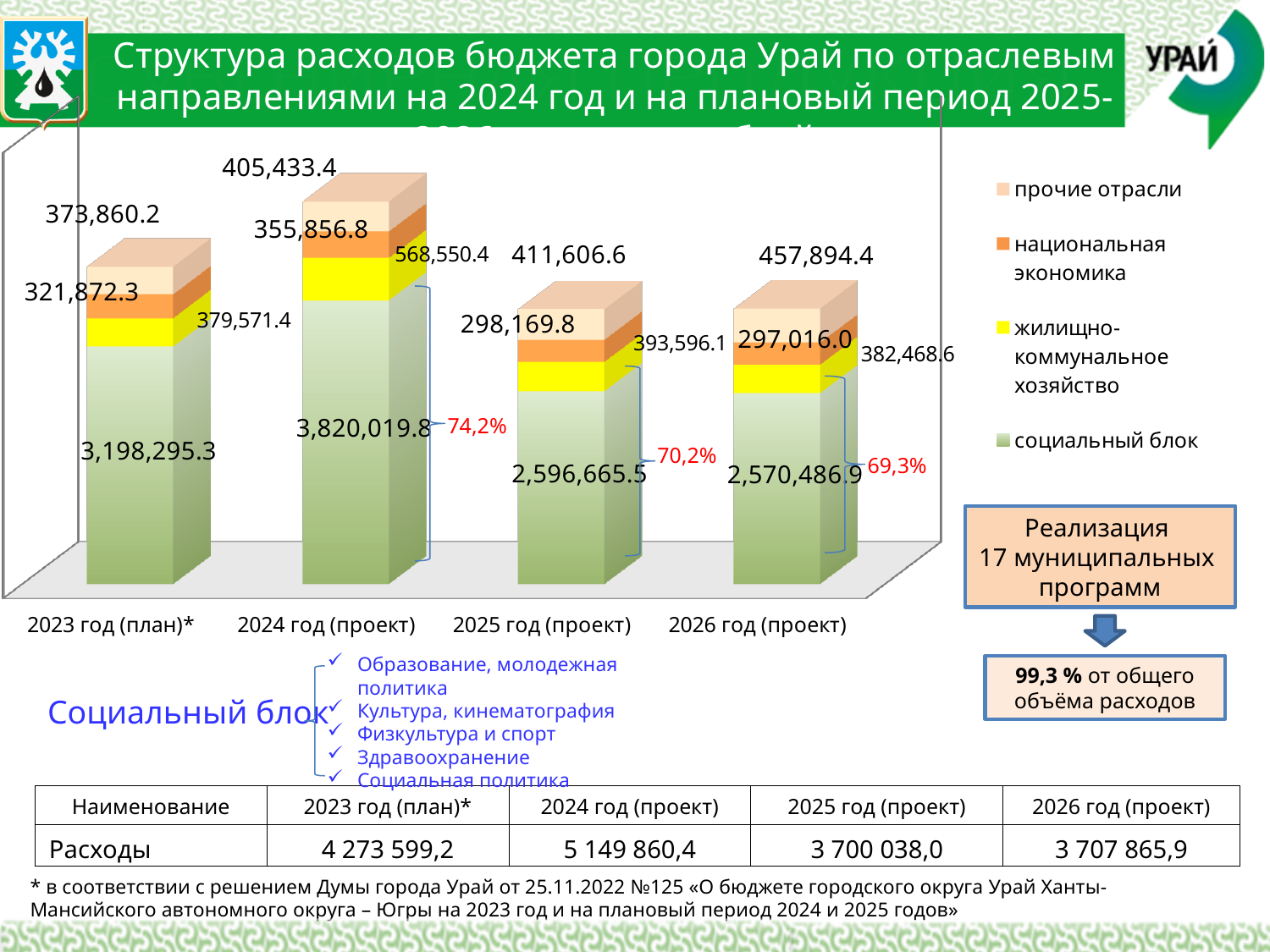
What is the value of the жилищно-коммунальное хозяйство segment for 2024 год (проект)? 568,550.4 What is the difference between the социальный блок values for 2024 год (проект) and 2025 год (проект)? 1,223,354.3 What kind of chart is shown on the slide? stacked bar chart What is the value of the социальный блок segment for 2024 год (проект)? 3,820,019.8 What is the value of the прочие отрасли segment for 2026 год (проект)? 457,894.4 How many series does the chart legend list? 4 How many year categories are plotted along the x axis of the chart? 4 Which year has the smallest социальный блок segment? 2026 год (проект) Which year has the largest социальный блок segment? 2024 год (проект) What is the value of the социальный блок segment for 2023 год (план)*? 3,198,295.3 Which is larger: the прочие отрасли segment for 2025 год (проект) or for 2026 год (проект)? 2026 год (проект) What share of the 2025 год (проект) bar does the социальный блок account for, according to the label on the chart? 70,2%